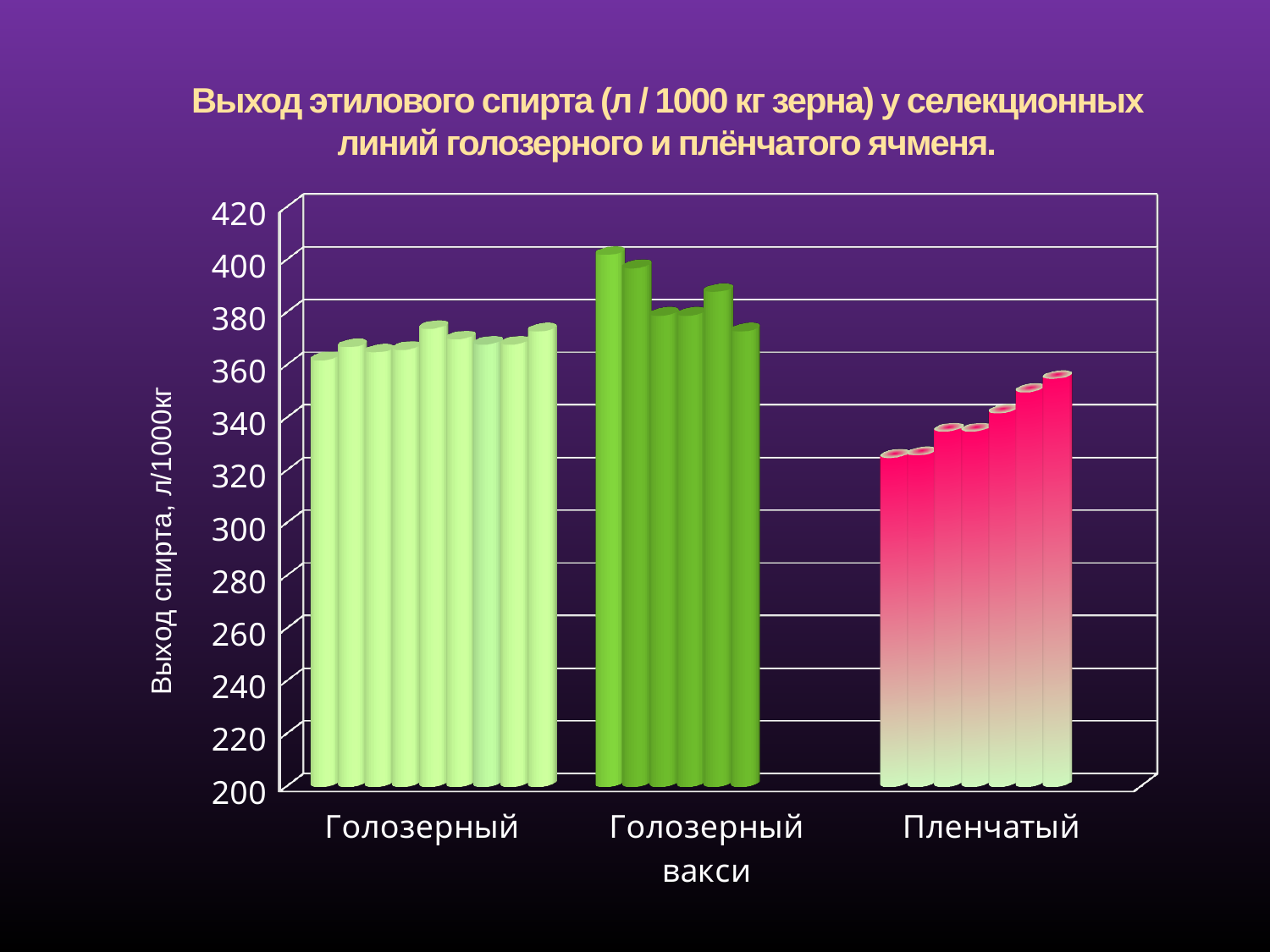
Which category contains the lowest bars? Пленчатый Are the bars for Голозерный higher or lower than the bars for Пленчатый? higher What kind of chart is shown on the slide? bar chart Are the values for Голозерный greater or less than 400? less Within the Пленчатый group, do the bars rise or fall from left to right? rise What is the label of the vertical axis? Выход спирта, л/1000кг Are the values for Пленчатый greater or less than 380? less What is the highest value shown on the vertical axis? 420 Are the values for Голозерный greater or less than 340? greater How many categories are shown on the x axis? 3 Which category contains the tallest bar? Голозерный вакси